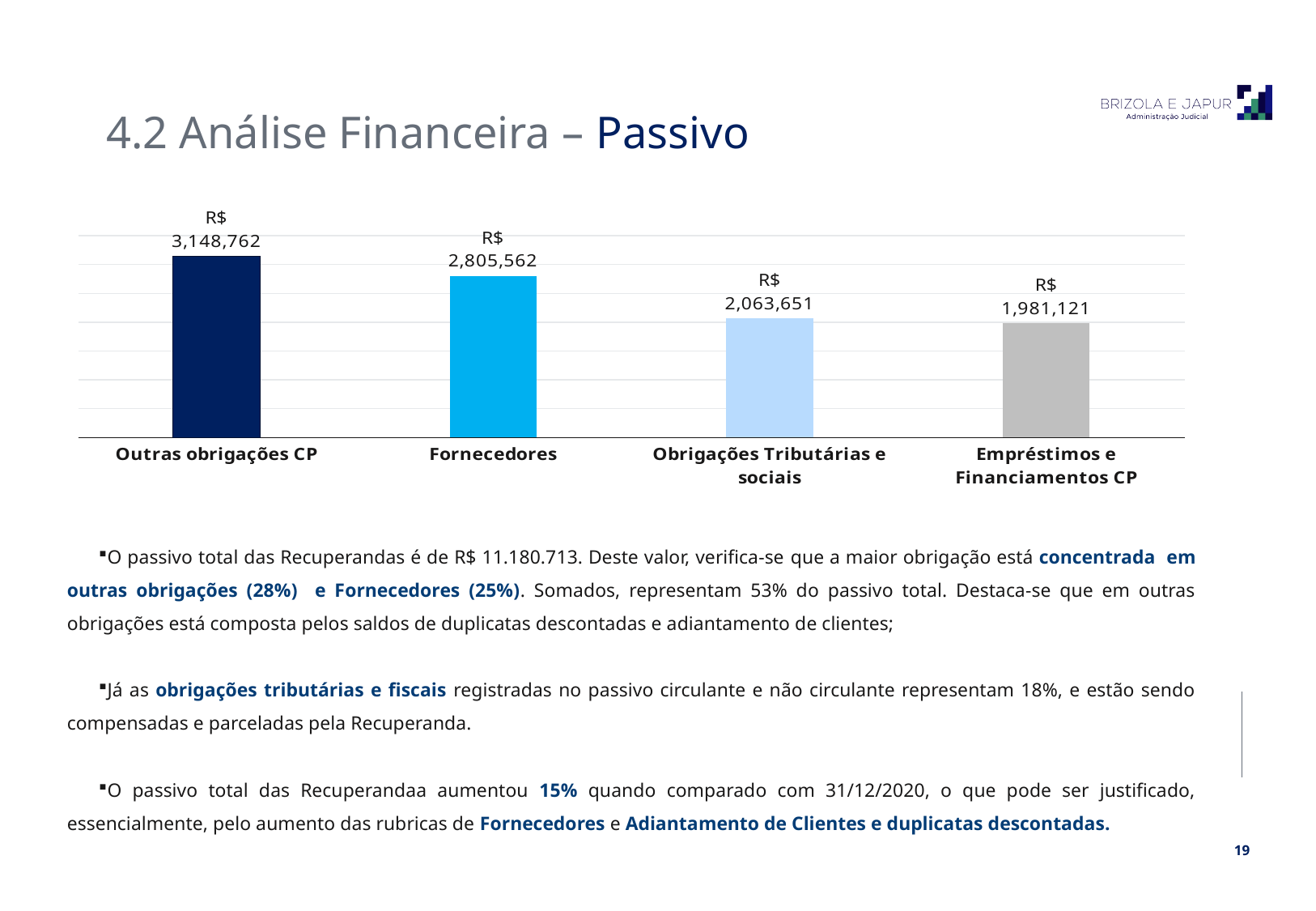
What is the value shown for Empréstimos e Financiamentos CP? R$ 1,981,121 Which is larger, the value for Fornecedores or the value for Obrigações Tributárias e sociais? Fornecedores How many categories are shown in the chart? 4 Do the values rise or fall from left to right across the categories? Fall What is the value shown for Fornecedores? R$ 2,805,562 What type of chart is shown on the slide? Bar chart Which category has the lowest value in the chart? Empréstimos e Financiamentos CP What is the value shown for Outras obrigações CP? R$ 3,148,762 What is the difference between the values for Outras obrigações CP and Fornecedores? R$ 343,200 What is the value shown for Obrigações Tributárias e sociais? R$ 2,063,651 What is the difference between the values for Obrigações Tributárias e sociais and Empréstimos e Financiamentos CP? R$ 82,530 Which category has the highest value in the chart? Outras obrigações CP